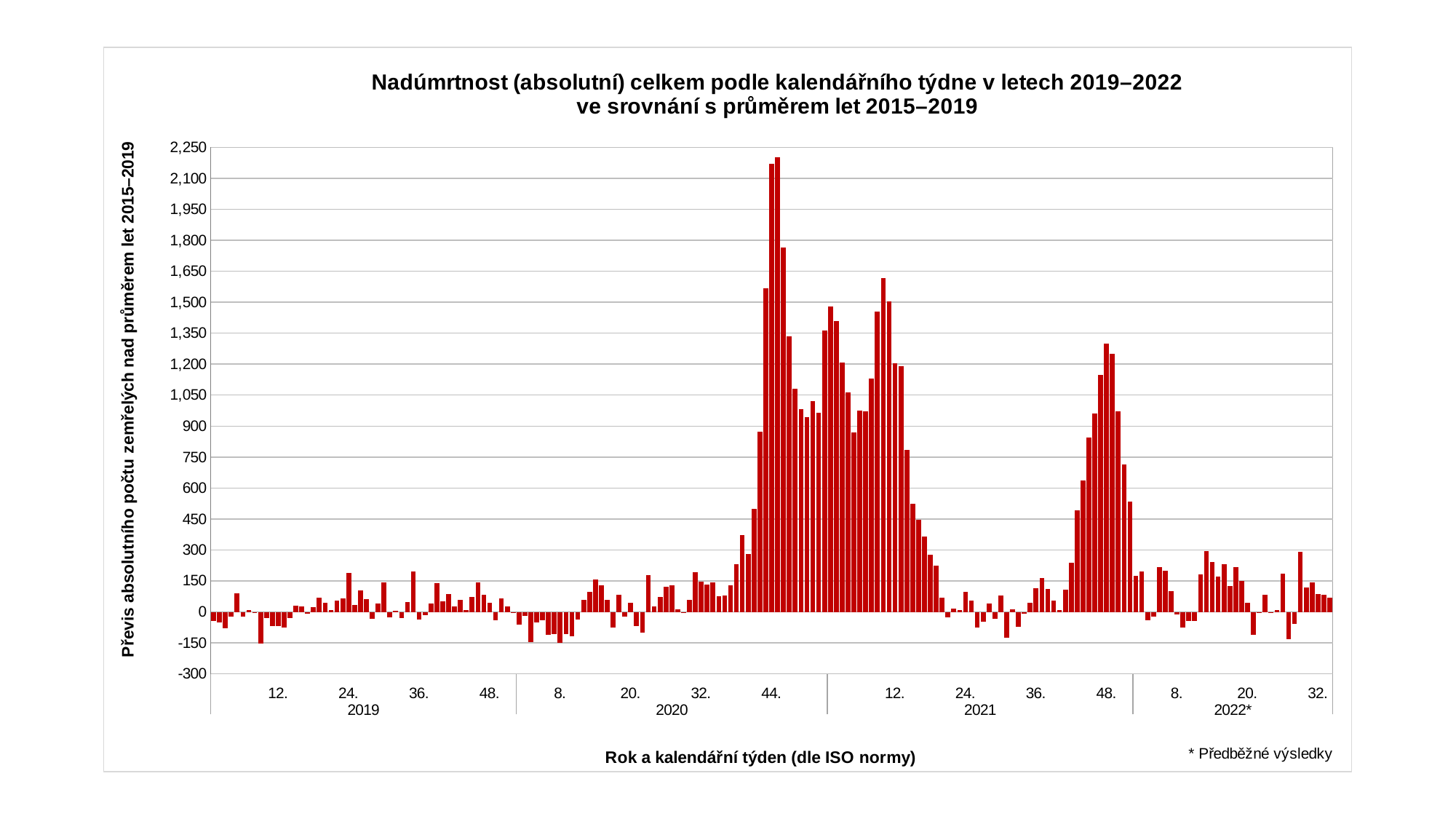
Do the values rise or fall from week 36 to week 48 of 2021? rise In which year does the tallest bar of the chart occur? 2020 Which year has the lowest peak value among 2019, 2020, 2021 and 2022? 2019 Is the value of the tallest bar in 2022 greater or less than 450? less Do the values rise or fall from week 48 of 2021 to week 8 of 2022? fall What is the title of the chart? Nadúmrtnost (absolutní) celkem podle kalendářního týdne v letech 2019–2022 ve srovnání s průměrem let 2015–2019 Is the value of the tallest bar in 2020 greater or less than 2,100? greater Which is larger: the peak value in late 2020 or the peak value in late 2021? late 2020 Is the value of the tallest bar in late 2021 (around week 48) greater or less than 1,050? greater What kind of chart is shown on the slide? bar chart What is the label of the x axis? Rok a kalendářní týden (dle ISO normy)